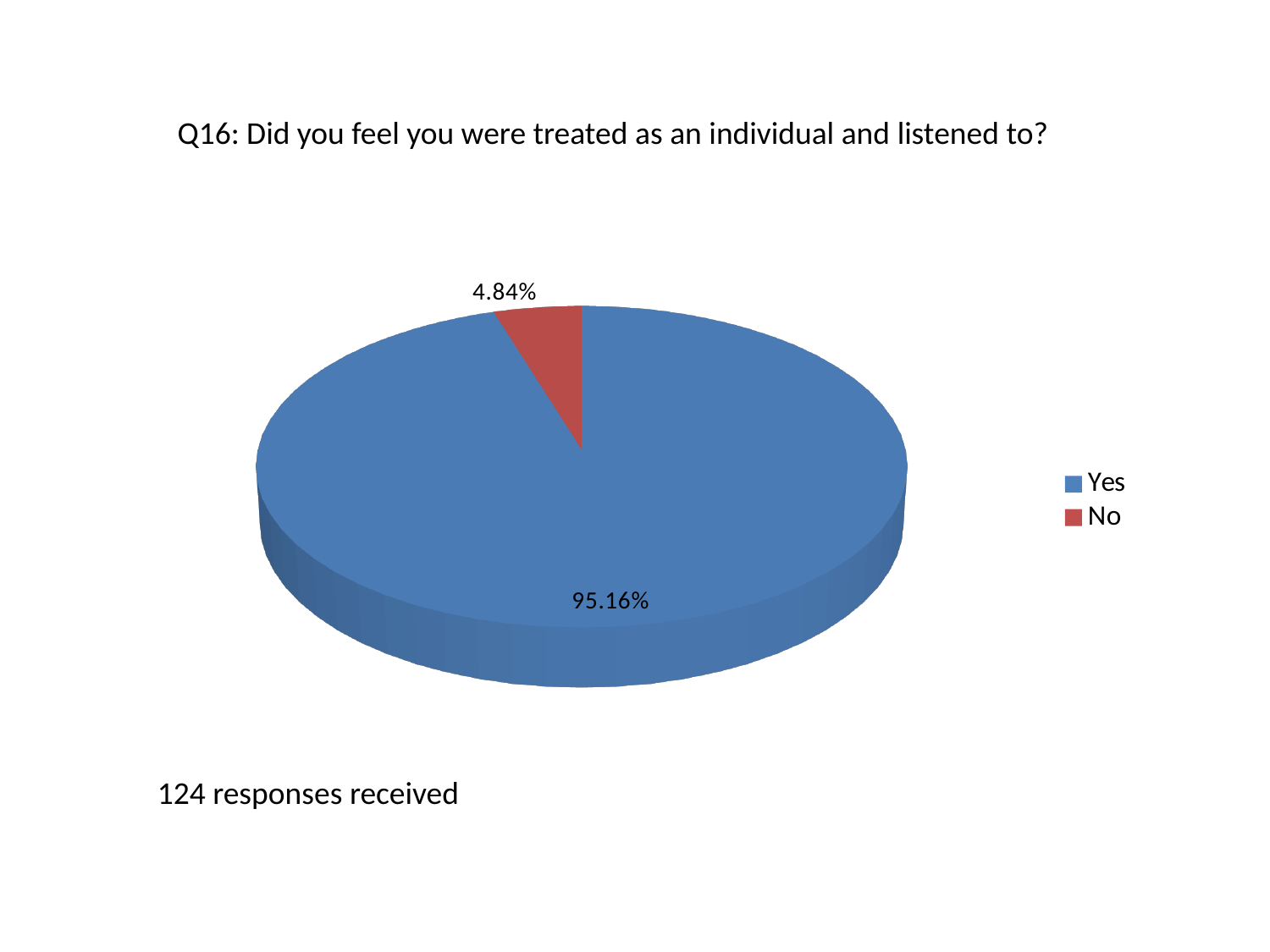
How many slices does the pie chart have? 2 What colour is the No slice? Red What percentage of respondents answered Yes? 95.16% How many entries does the legend list? 2 Which response has the smallest share of the pie? No How many responses were received according to the slide? 124 What is the title of the chart? Q16: Did you feel you were treated as an individual and listened to? What percentage of respondents answered No? 4.84% What kind of chart is shown on the slide? Pie chart What is the difference in percentage points between the Yes and No shares? 90.32 Which is larger, the Yes share or the No share? Yes Which response has the largest share of the pie? Yes